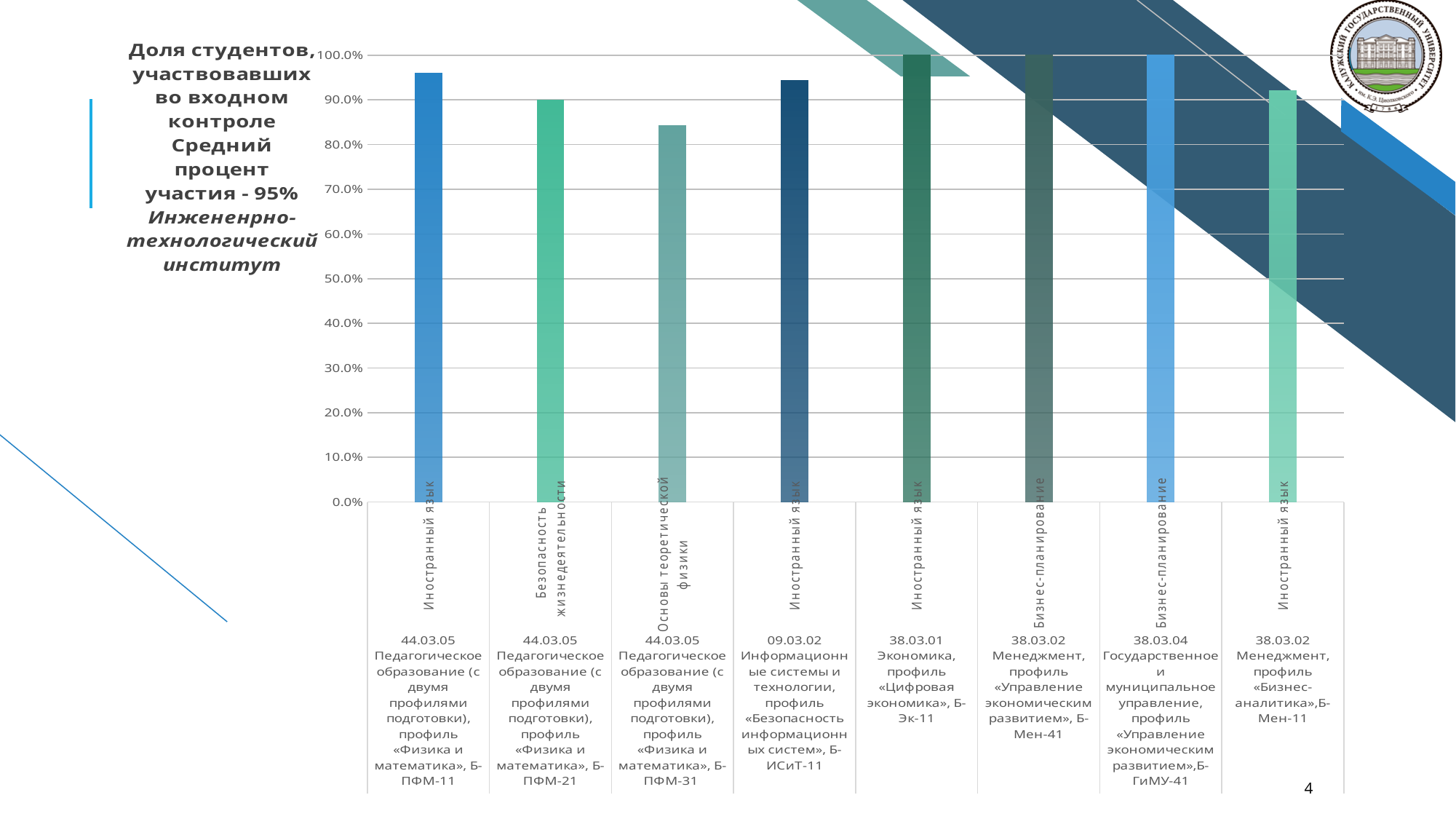
What is the value for 38.03.01 Экономика, Б-Эк-11 (Иностранный язык)? 100.0% How many bars reach 100.0%? 3 Which is larger: the value for Б-ИСиТ-11 (Иностранный язык) or the value for Б-ПФМ-31 (Основы теоретической физики)? Б-ИСиТ-11 Is the value for Б-ПФМ-31 (Основы теоретической физики) greater or less than 90%? less What is the value for 38.03.04 Государственное и муниципальное управление, Б-ГиМУ-41 (Бизнес-планирование)? 100.0% Is the value for Б-ПФМ-11 (Иностранный язык) greater or less than 90%? greater What is the value for 44.03.05 Педагогическое образование, Б-ПФМ-21 (Безопасность жизнедеятельности)? 90.0% Which category has the lowest value in the chart? 44.03.05 Педагогическое образование, Б-ПФМ-31 (Основы теоретической физики) What type of chart is shown on the slide? bar chart According to the text next to the chart, what is the average participation percentage (Средний процент участия)? 95% How many bars (categories) are plotted in the chart? 8 What is the difference between the value for Б-Эк-11 and the value for Б-ПФМ-21? 10.0%